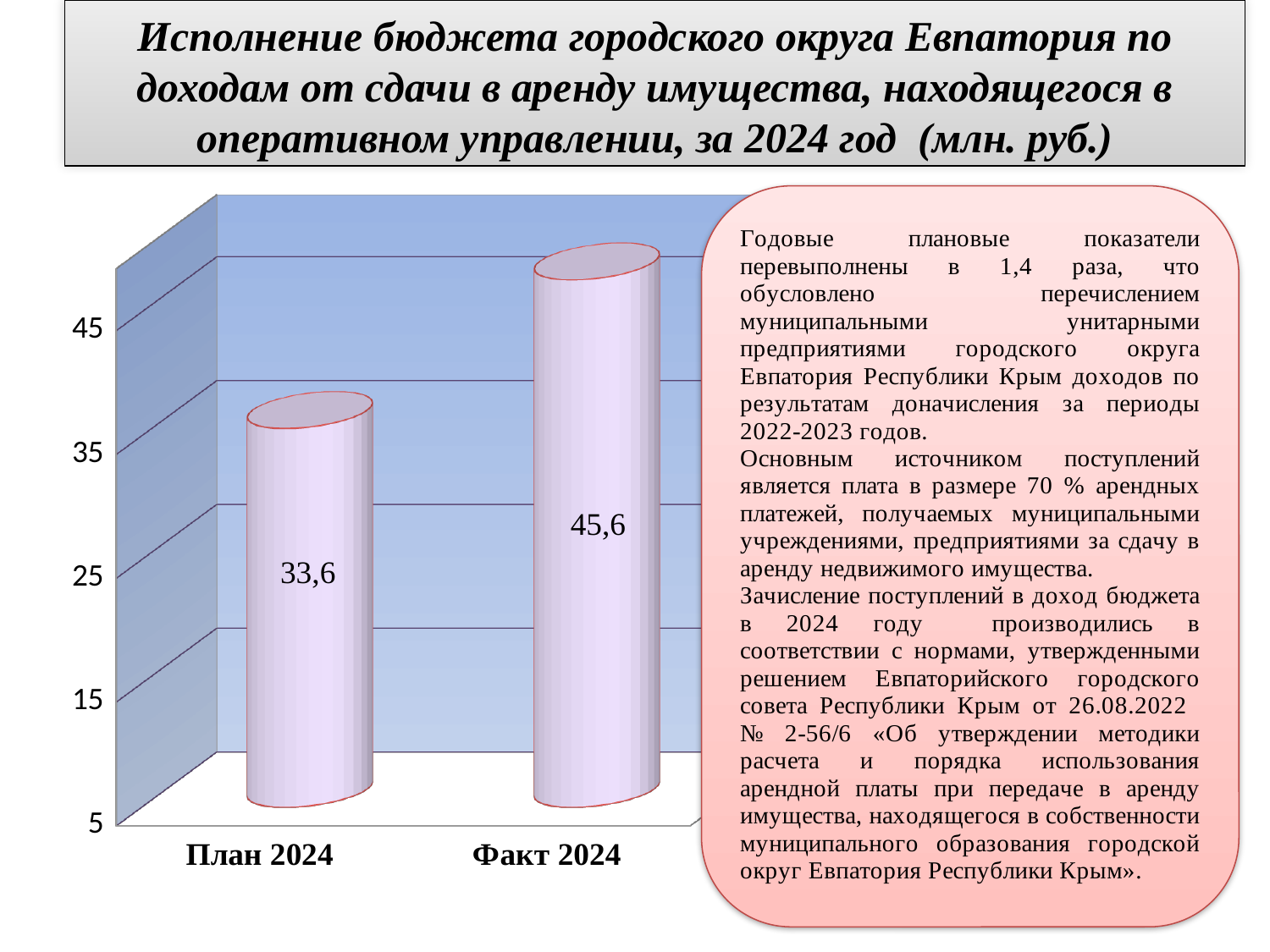
Which category has the highest value? Факт 2024 What is the value for Факт 2024? 45,6 Is the value for План 2024 greater or less than 25? greater What is the value for План 2024? 33,6 Is the value for Факт 2024 greater or less than 35? greater What is the difference between the values for Факт 2024 and План 2024? 12 What kind of chart is shown on the slide? bar chart Which is larger, the value for План 2024 or the value for Факт 2024? Факт 2024 Do the values rise or fall from План 2024 to Факт 2024? rise Which category has the lowest value? План 2024 What unit of measurement is given in the chart title? млн. руб. How many categories are shown on the chart? 2